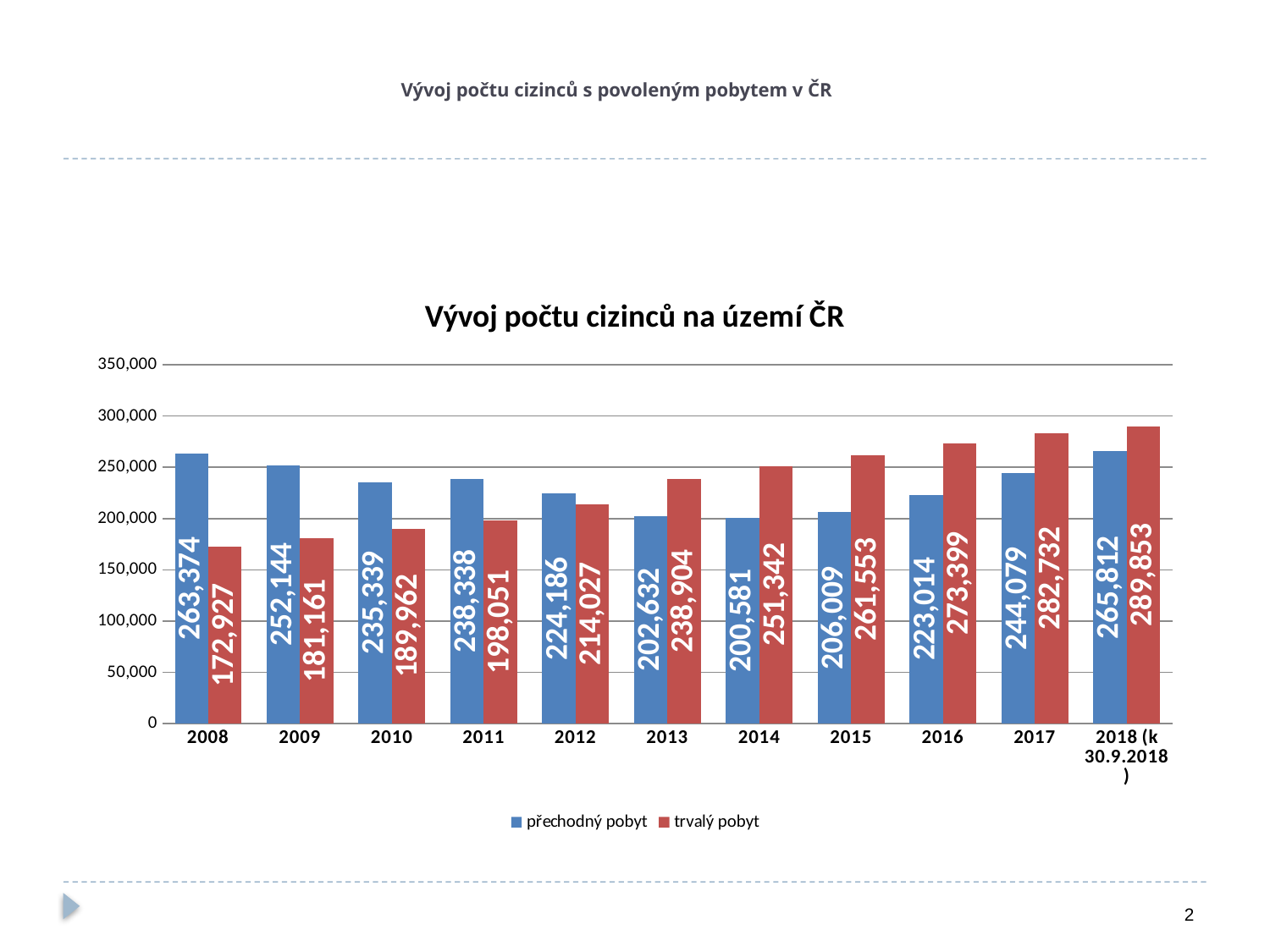
In which year is the value for trvalý pobyt lowest? 2008 How many years (categories) are shown on the x axis? 11 Does the value for trvalý pobyt rise or fall from 2008 to 2018? rise Is the value for přechodný pobyt in 2015 greater or less than 250,000? less In 2012, which is larger: přechodný pobyt or trvalý pobyt? přechodný pobyt How many series does the legend list? 2 What is the value for přechodný pobyt in 2010? 235,339 What type of chart is shown on the slide? bar chart What is the title of the chart? Vývoj počtu cizinců na území ČR What is the difference between trvalý pobyt and přechodný pobyt in 2018 (k 30.9.2018)? 24,041 In which year is the value for trvalý pobyt highest? 2018 (k 30.9.2018) What is the value for trvalý pobyt in 2014? 251,342